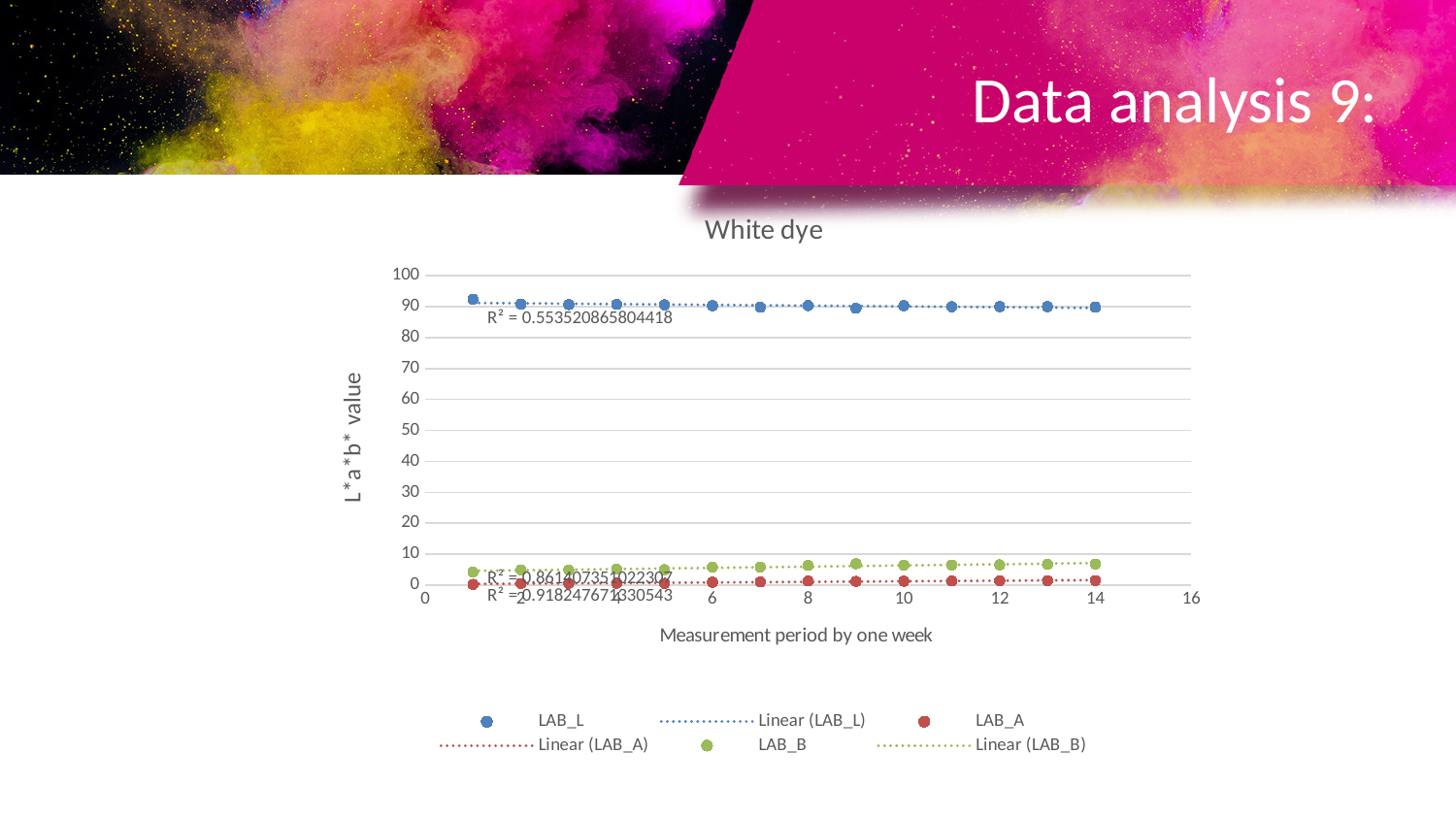
How many data points are plotted for the LAB_L series? 14 What is the x-axis title of the chart? Measurement period by one week Is the LAB_A value at week 1 greater or less than 10? less Which of the three plotted series has the lowest values? LAB_A What is the title of the chart? White dye Do the LAB_L values rise or fall along the x axis? fall Which series has the highest values, LAB_L or LAB_B? LAB_L What kind of chart is shown on the slide? scatter chart What R² value is printed next to the LAB_L trendline? 0.553520865804418 How many entries does the chart legend list? 6 Are the LAB_L values greater or less than 80? greater Is the LAB_B value at week 14 greater or less than 10? less